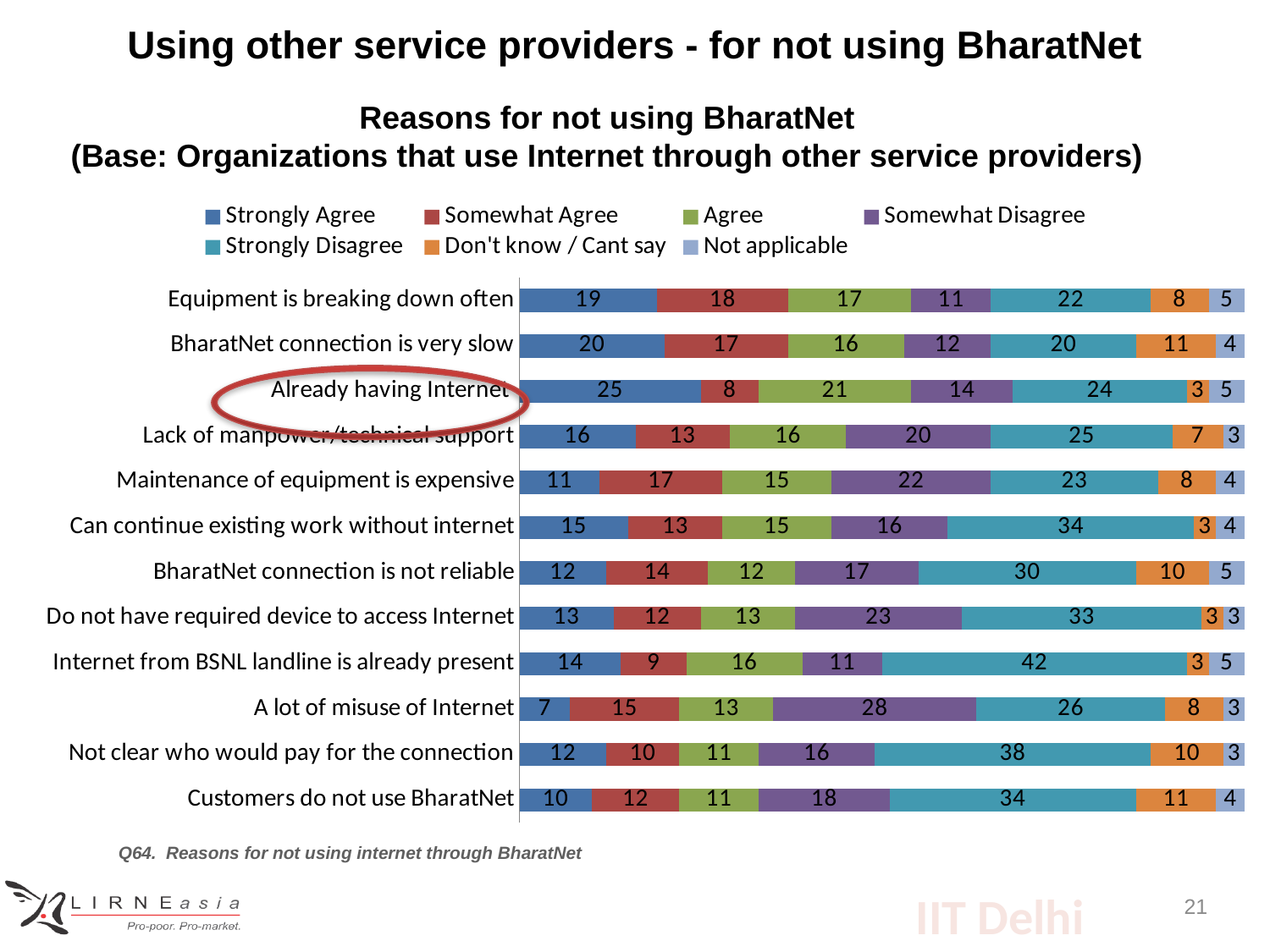
Which reason has the highest Strongly Agree value? Already having Internet How many reasons (categories) are plotted in the chart? 12 What is the Strongly Agree value for "Already having Internet"? 25 What kind of chart is shown on the slide? Stacked bar chart What is the Strongly Disagree value for "Internet from BSNL landline is already present"? 42 What is the total of the stacked bar for "Equipment is breaking down often"? 100 What is the Somewhat Disagree value for "A lot of misuse of Internet"? 28 Which reason has the lowest Strongly Agree value? A lot of misuse of Internet How many series does the legend list? 7 Which reason has the highest Strongly Disagree value? Internet from BSNL landline is already present What is the difference between the Strongly Disagree values for "Not clear who would pay for the connection" and "Customers do not use BharatNet"? 4 Which has a larger Somewhat Agree value: "Equipment is breaking down often" or "Already having Internet"? Equipment is breaking down often